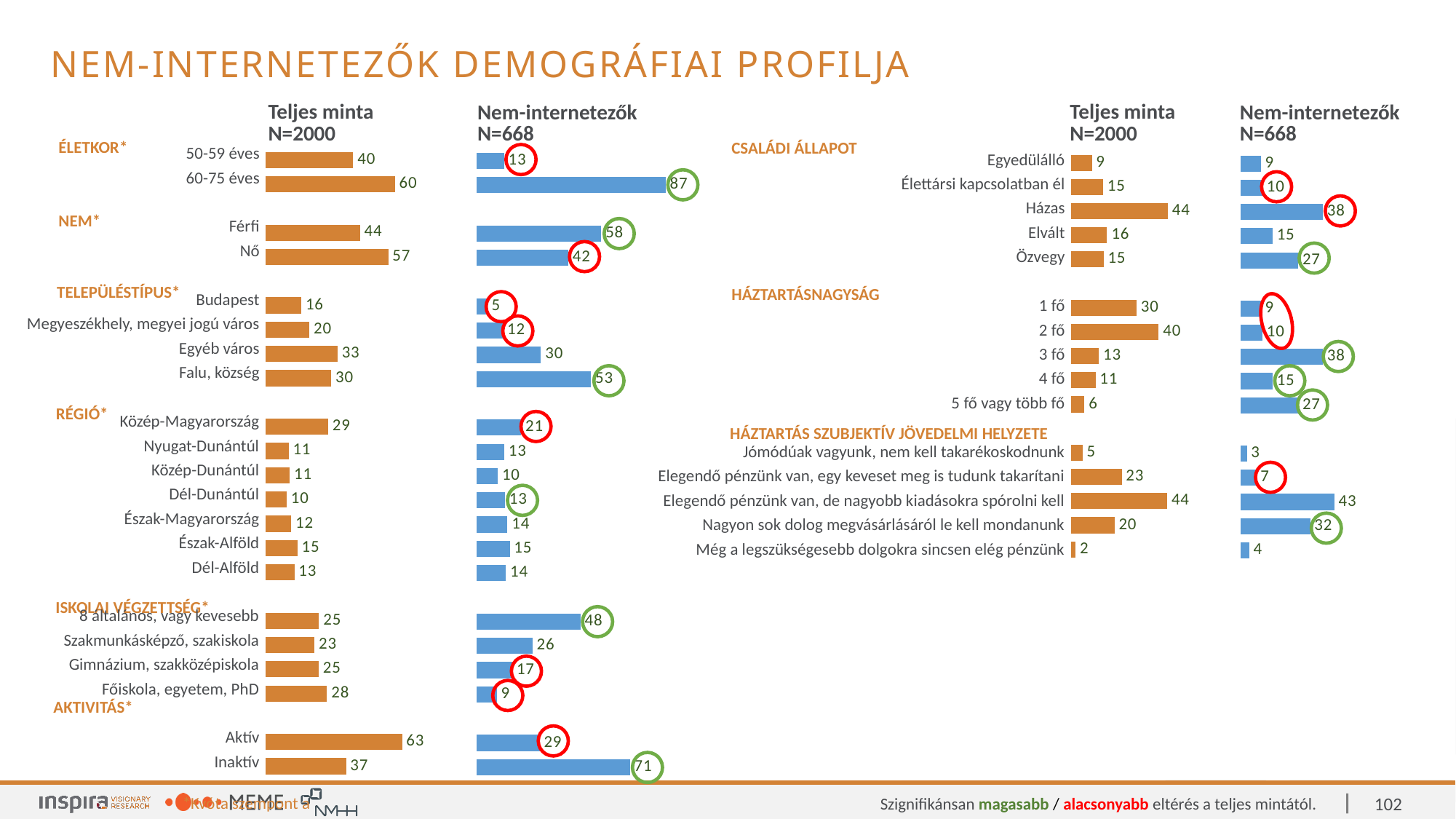
In the AKTIVITÁS section, which is larger: the Nem-internetezők value for Aktív or for Inaktív? Inaktív In the CSALÁDI ÁLLAPOT section, what is the Teljes minta value for Házas? 44 How many categories are listed in the RÉGIÓ section? 7 In the TELEPÜLÉSTÍPUS section, which category has the lowest Nem-internetezők value? Budapest In the ÉLETKOR section, what is the Nem-internetezők (N=668) value for 60-75 éves? 87 In the HÁZTARTÁSNAGYSÁG section, what is the Nem-internetezők value for 5 fő vagy több fő? 27 In the ISKOLAI VÉGZETTSÉG section, what is the Nem-internetezők value for Főiskola, egyetem, PhD? 9 What type of chart is used on this slide? Bar chart In the ÉLETKOR section, what is the Teljes minta (N=2000) value for 50-59 éves? 40 In the NEM section, what is the difference between the Nem-internetezők values for Férfi and Nő? 16 In the TELEPÜLÉSTÍPUS section, which category has the highest Nem-internetezők value? Falu, község In the HÁZTARTÁS SZUBJEKTÍV JÖVEDELMI HELYZETE section, which category has the highest Nem-internetezők value? Elegendő pénzünk van, de nagyobb kiadásokra spórolni kell